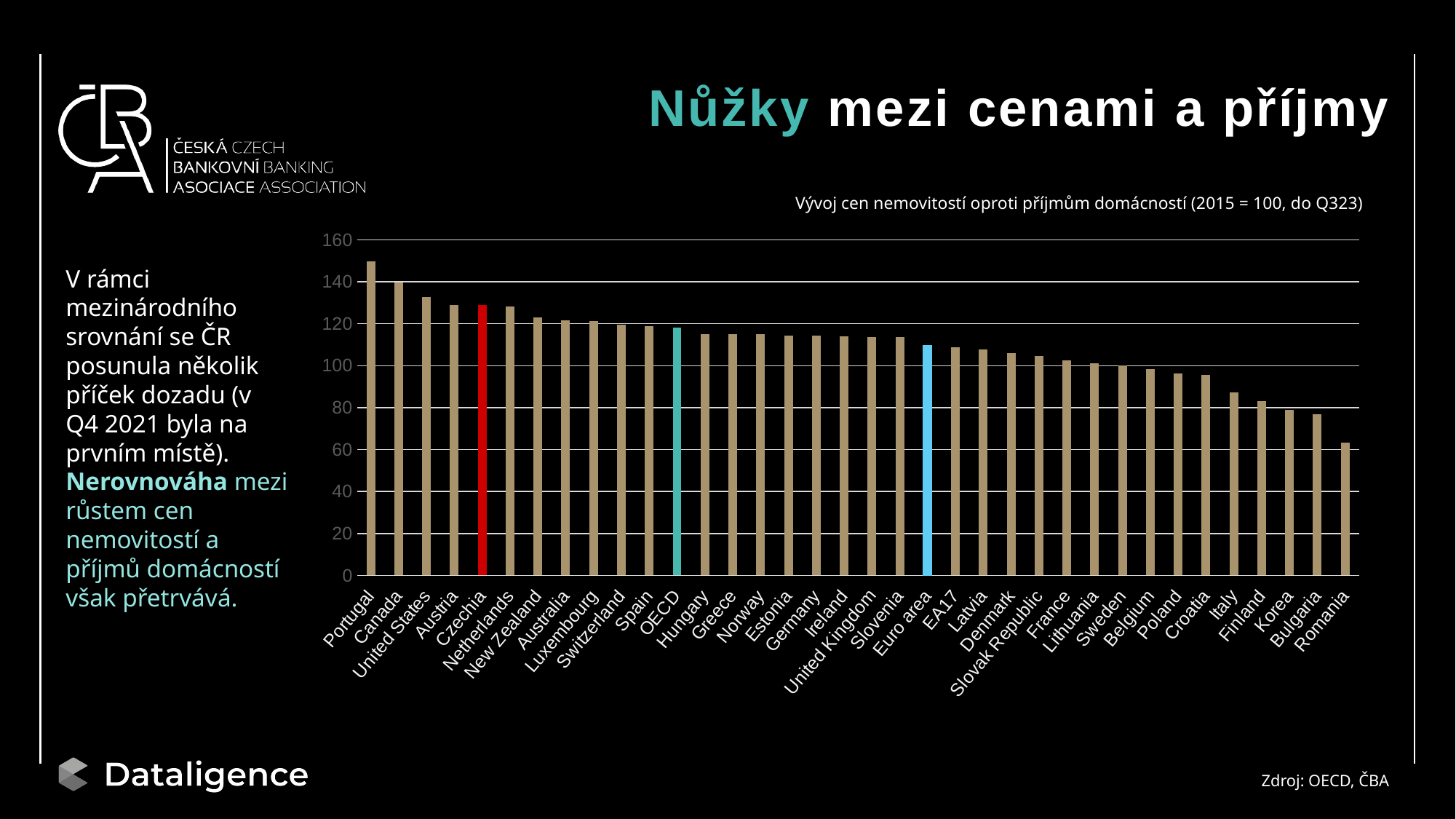
Which has a larger value, Czechia or Spain? Czechia Is the value for Romania greater or less than 80? less Is the value for Portugal greater or less than 140? greater Which has a larger value, Portugal or Canada? Portugal Do the values rise or fall moving from left to right along the x axis? fall Is the value for Italy greater or less than 100? less How many categories are plotted in the chart? 36 Which category has the lowest value in the chart? Romania Which category has the highest value in the chart? Portugal What kind of chart is shown on the slide? bar chart